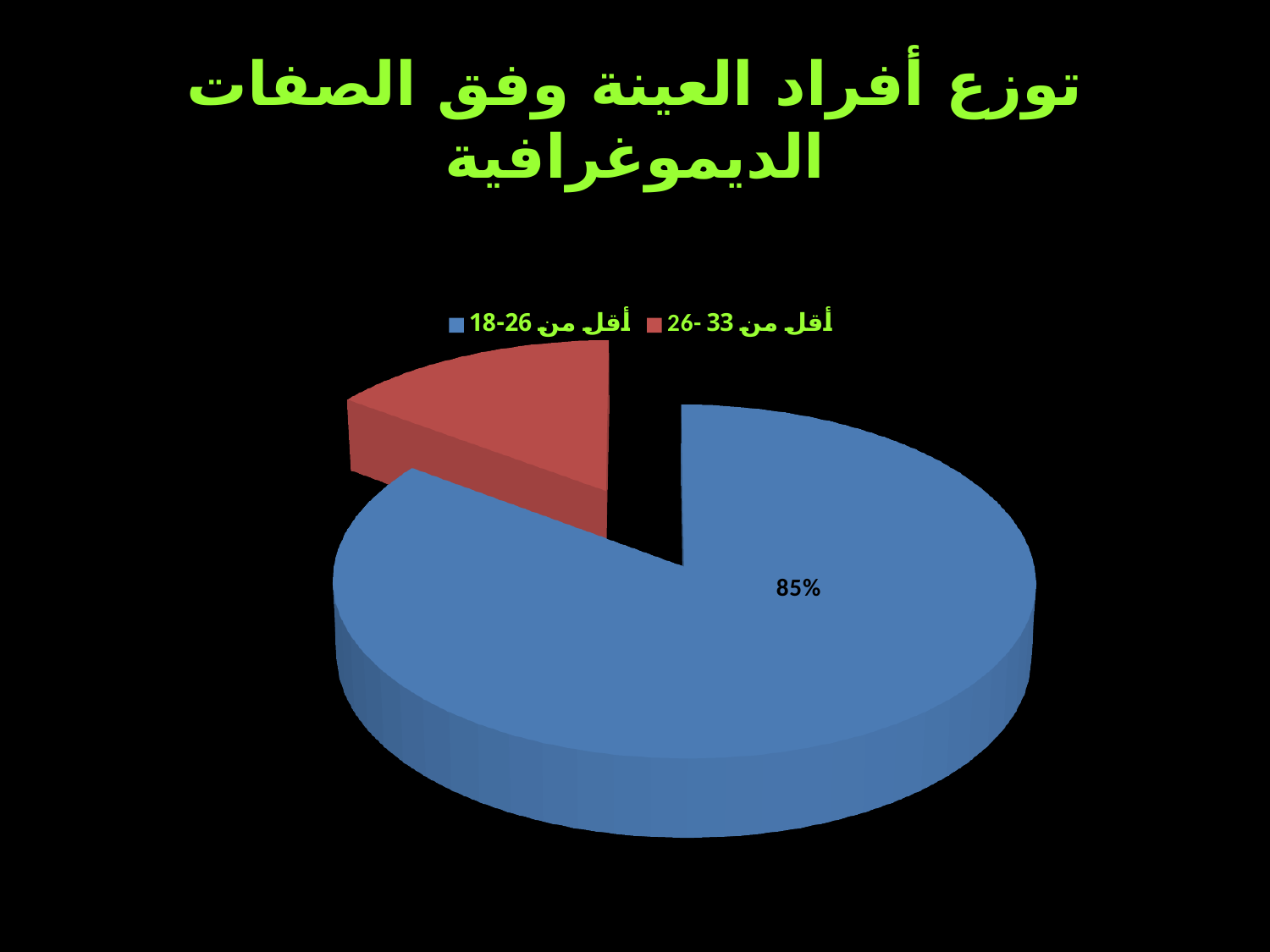
How many entries does the legend list? 2 What colour is the 18-أقل من 26 slice? blue Which slice is larger, 18-أقل من 26 or 26-أقل من 33? 18-أقل من 26 Which category has the smallest slice of the pie? 26-أقل من 33 How many slices does the pie chart have? 2 What is the title of the slide? توزع أفراد العينة وفق الصفات الديموغرافية Which category has the largest slice of the pie? 18-أقل من 26 Is the share for 26-أقل من 33 greater or less than 50%? less What percentage is shown for the 18-أقل من 26 slice? 85% What kind of chart is shown on the slide? pie chart